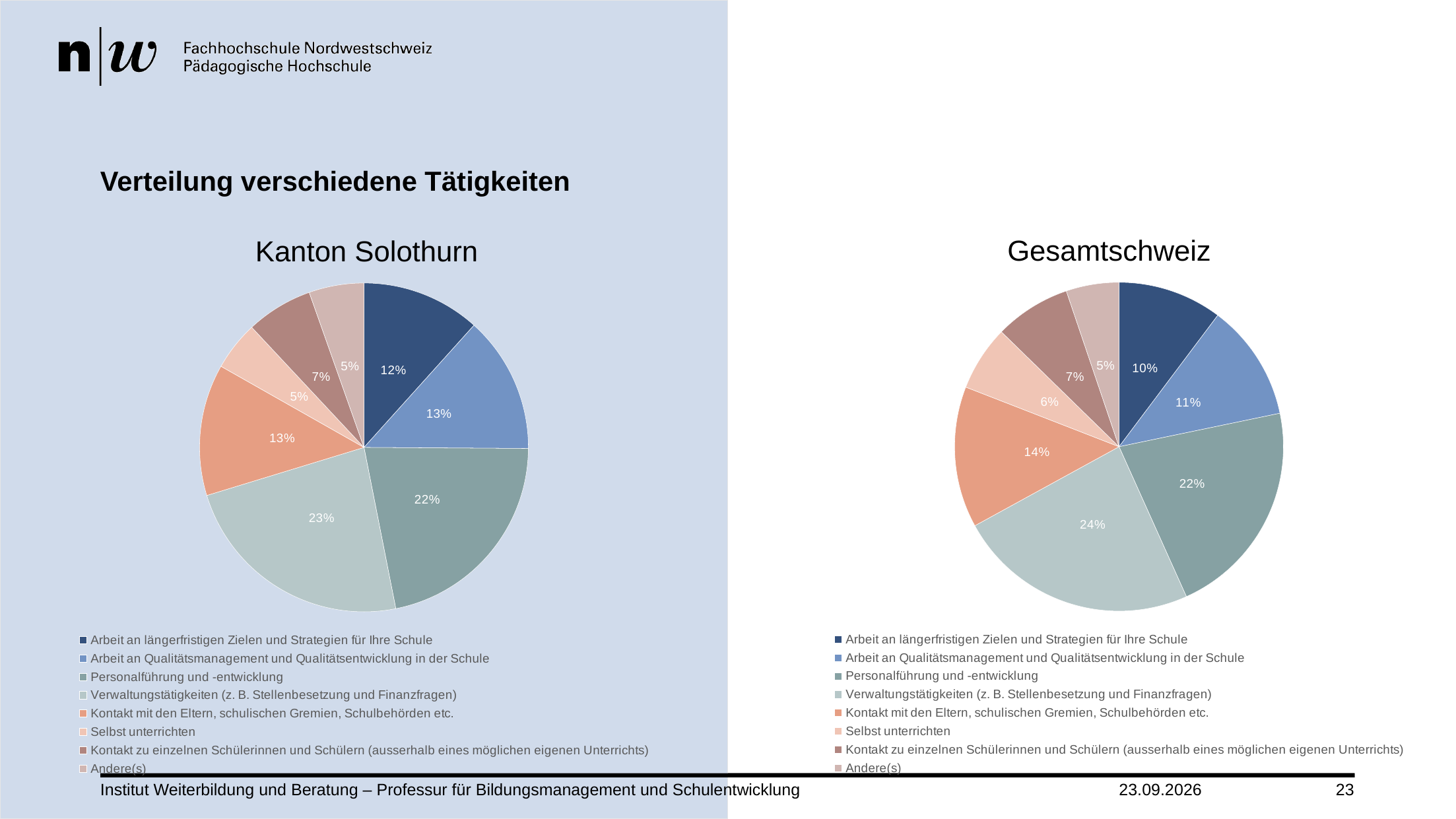
In the Gesamtschweiz chart, which is larger: Arbeit an Qualitätsmanagement und Qualitätsentwicklung in der Schule or Kontakt mit den Eltern, schulischen Gremien, Schulbehörden etc.? Kontakt mit den Eltern, schulischen Gremien, Schulbehörden etc. In the Kanton Solothurn chart, what is the difference in percentage points between Personalführung und -entwicklung and Selbst unterrichten? 17 What type of chart is used for Gesamtschweiz? Pie chart In the Gesamtschweiz chart, which category has the largest slice? Verwaltungstätigkeiten (z. B. Stellenbesetzung und Finanzfragen) What is the title of the slide above the two charts? Verteilung verschiedene Tätigkeiten In the Gesamtschweiz chart, what share is shown for Personalführung und -entwicklung? 22% In the Kanton Solothurn chart, which category has the largest slice? Verwaltungstätigkeiten (z. B. Stellenbesetzung und Finanzfragen) In the Kanton Solothurn chart, what share is shown for Arbeit an längerfristigen Zielen und Strategien für Ihre Schule? 12% In the Gesamtschweiz chart, which category has the smallest slice? Andere(s) How many categories does the Kanton Solothurn pie chart show? 8 In the Gesamtschweiz chart, what share is shown for Kontakt mit den Eltern, schulischen Gremien, Schulbehörden etc.? 14% In the Kanton Solothurn chart, what share is shown for Verwaltungstätigkeiten (z. B. Stellenbesetzung und Finanzfragen)? 23%